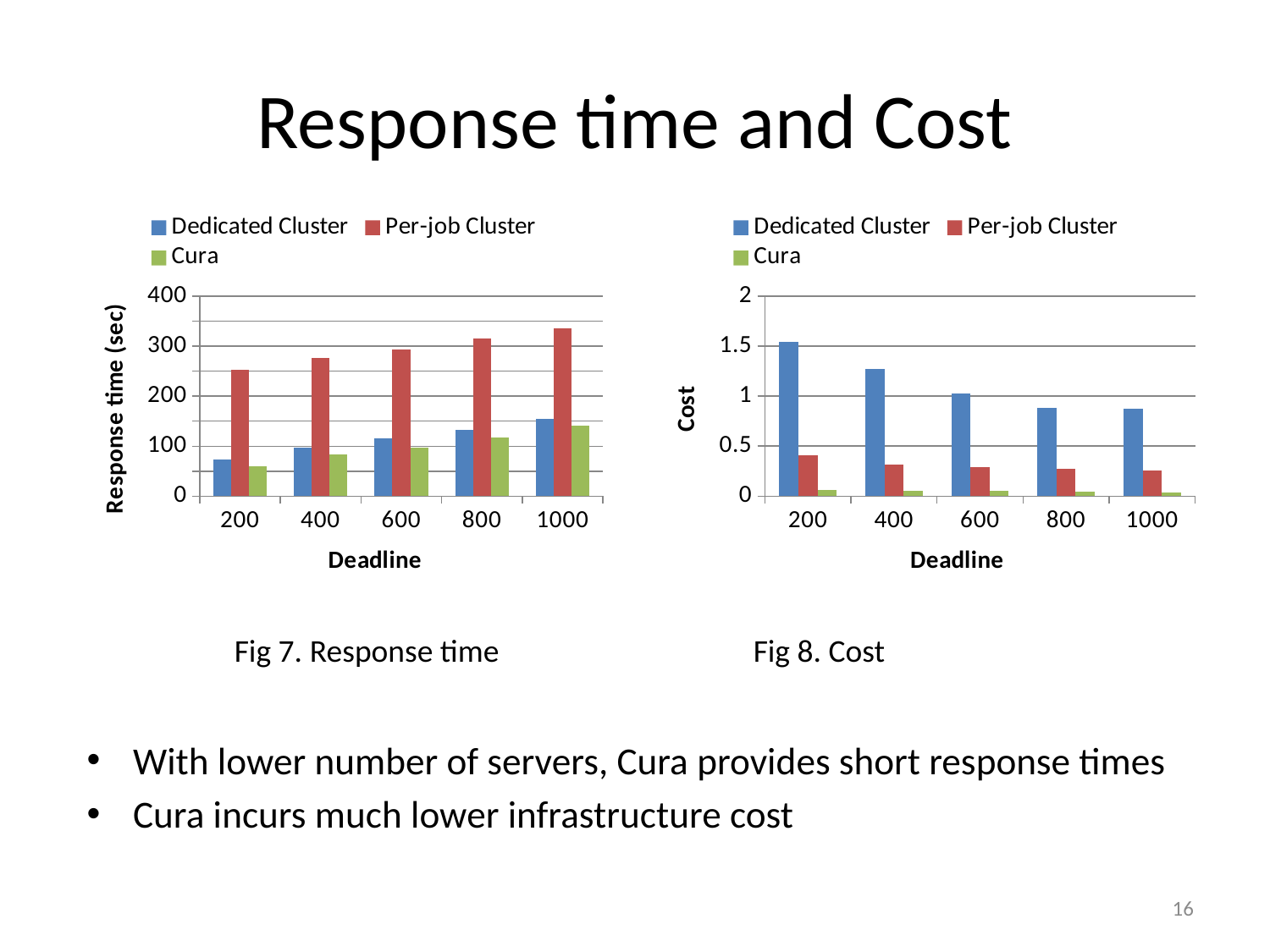
In Fig 8. Cost, does the Dedicated Cluster cost rise or fall as the deadline increases? falls In Fig 7. Response time, how many series does the legend list? 3 In Fig 7. Response time, at deadline 600, which is larger: Per-job Cluster or Dedicated Cluster? Per-job Cluster In Fig 7. Response time, is the Per-job Cluster value at deadline 200 greater or less than 200? greater In Fig 8. Cost, is the Dedicated Cluster value at deadline 800 greater or less than 1? less In Fig 7. Response time, at which deadline is the Per-job Cluster response time highest? 1000 In Fig 8. Cost, which series has the highest cost at deadline 200? Dedicated Cluster In Fig 7. Response time, does the Per-job Cluster response time rise or fall as the deadline increases? rises In Fig 8. Cost, what is the label of the y axis? Cost In Fig 7. Response time, what kind of chart is shown? bar chart In Fig 8. Cost, is the Dedicated Cluster value at deadline 400 greater or less than 1? greater In Fig 7. Response time, how many deadline categories are shown on the x axis? 5